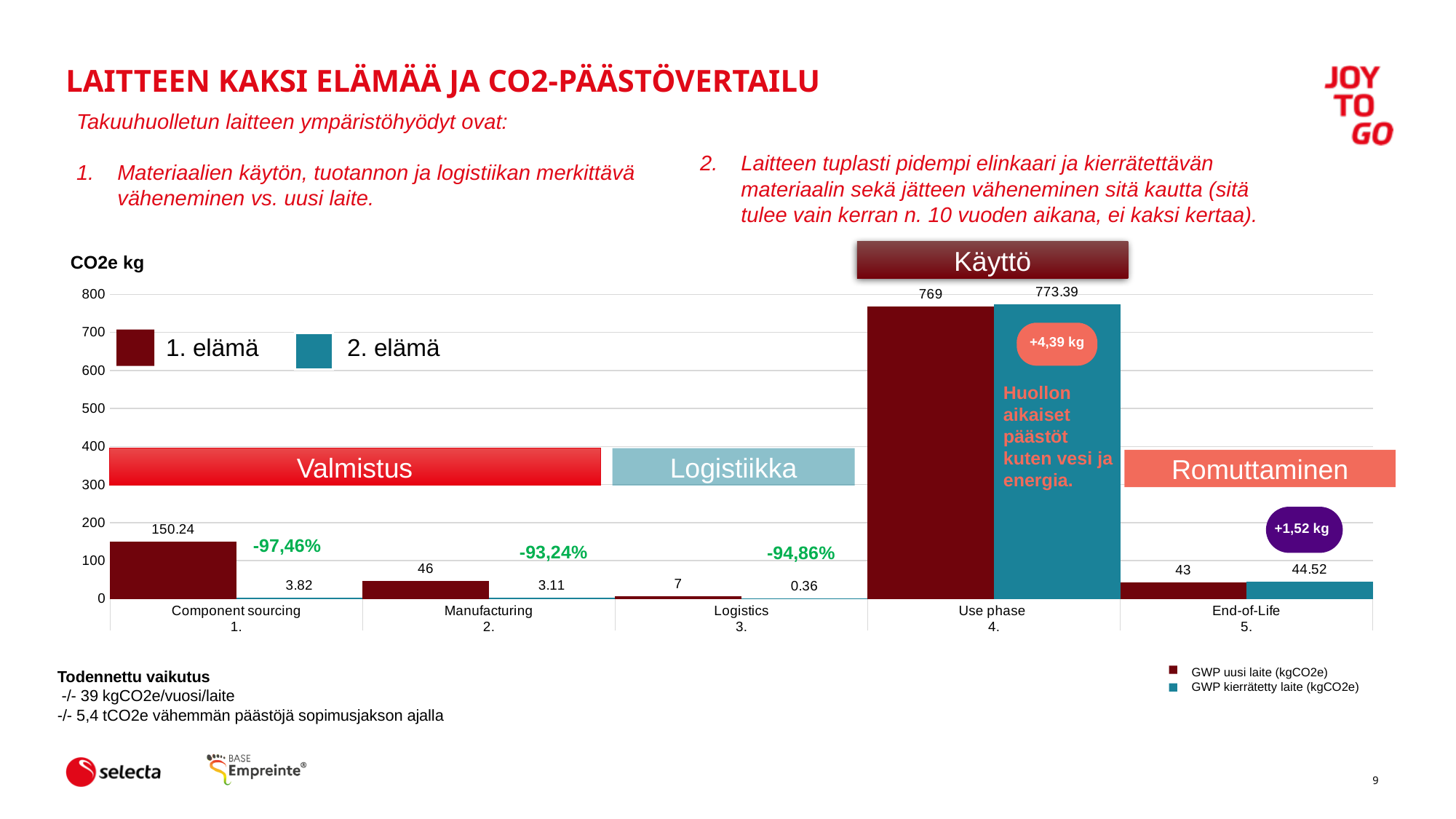
How many series does the chart's legend list? 2 What is the value for Logistics in the 2. elämä series? 0.36 What is the value for Use phase in the 2. elämä series? 773.39 How many categories are shown on the x axis of the chart? 5 What unit is shown on the y axis label of the chart? CO2e kg Which category has the highest value in the 1. elämä series? Use phase Which category has the lowest value in the 2. elämä series? Logistics What kind of chart is shown on the slide? Bar chart Which is larger for Component sourcing: the 1. elämä value or the 2. elämä value? 1. elämä What is the value for Component sourcing in the 1. elämä series? 150.24 What is the value for End-of-Life in the 1. elämä series? 43 What is the difference between the 1. elämä and 2. elämä values for Manufacturing? 42.89